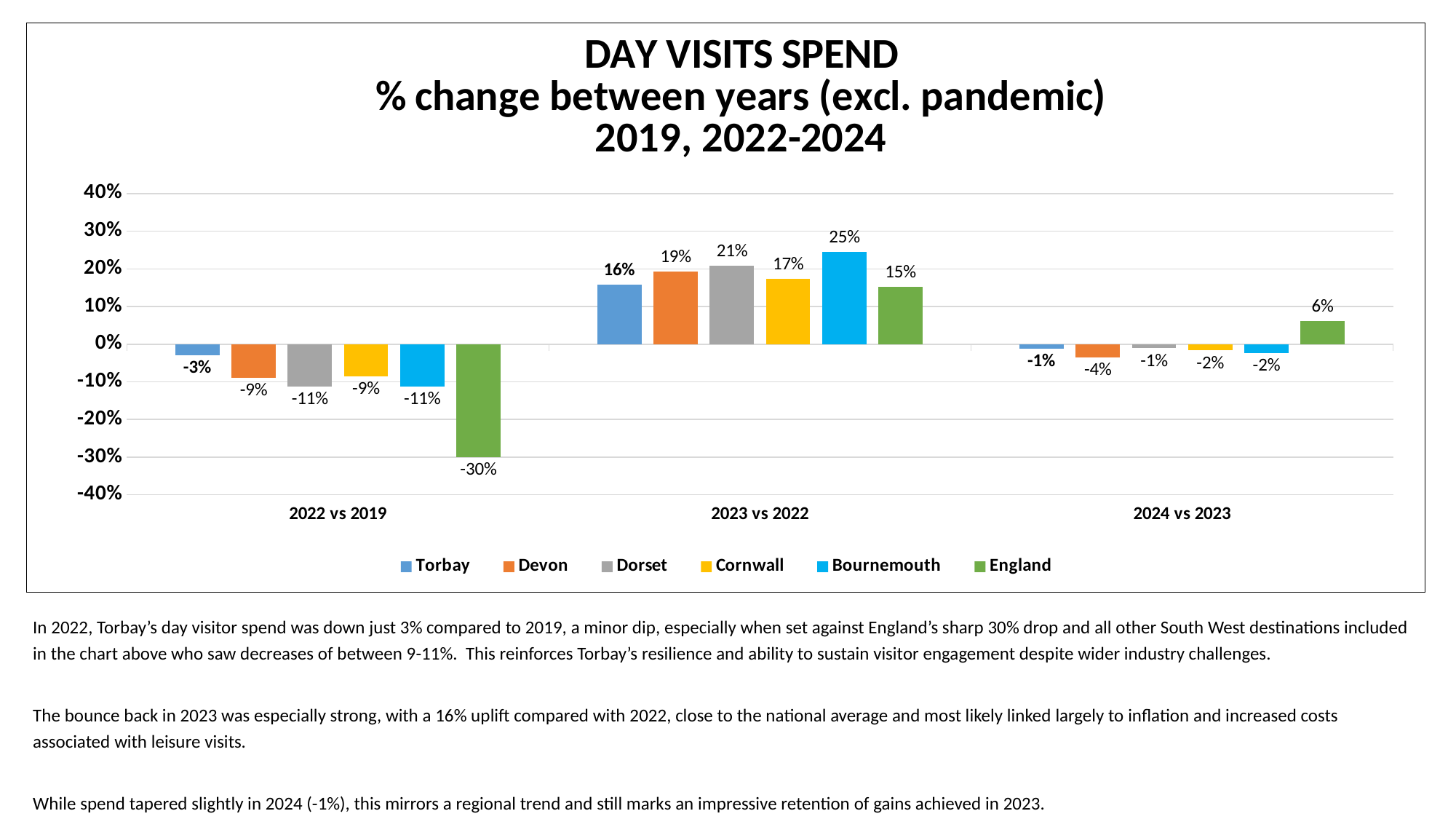
What is the difference between the Bournemouth and Torbay values in the 2023 vs 2022 group? 9 percentage points Which series has the lowest value in the 2022 vs 2019 group? England What is the value for England in the 2024 vs 2023 group? 6% What is the value for Bournemouth in the 2023 vs 2022 group? 25% Which series has the highest value in the 2023 vs 2022 group? Bournemouth In the 2022 vs 2019 group, which is larger, the value for Torbay or the value for Devon? Torbay How many category groups are shown on the x axis? 3 Which colour represents England in the legend? Green What is the value for Torbay in the 2022 vs 2019 group? -3% What kind of chart is this? Bar chart What is the value for Devon in the 2024 vs 2023 group? -4% How many series does the legend list? 6